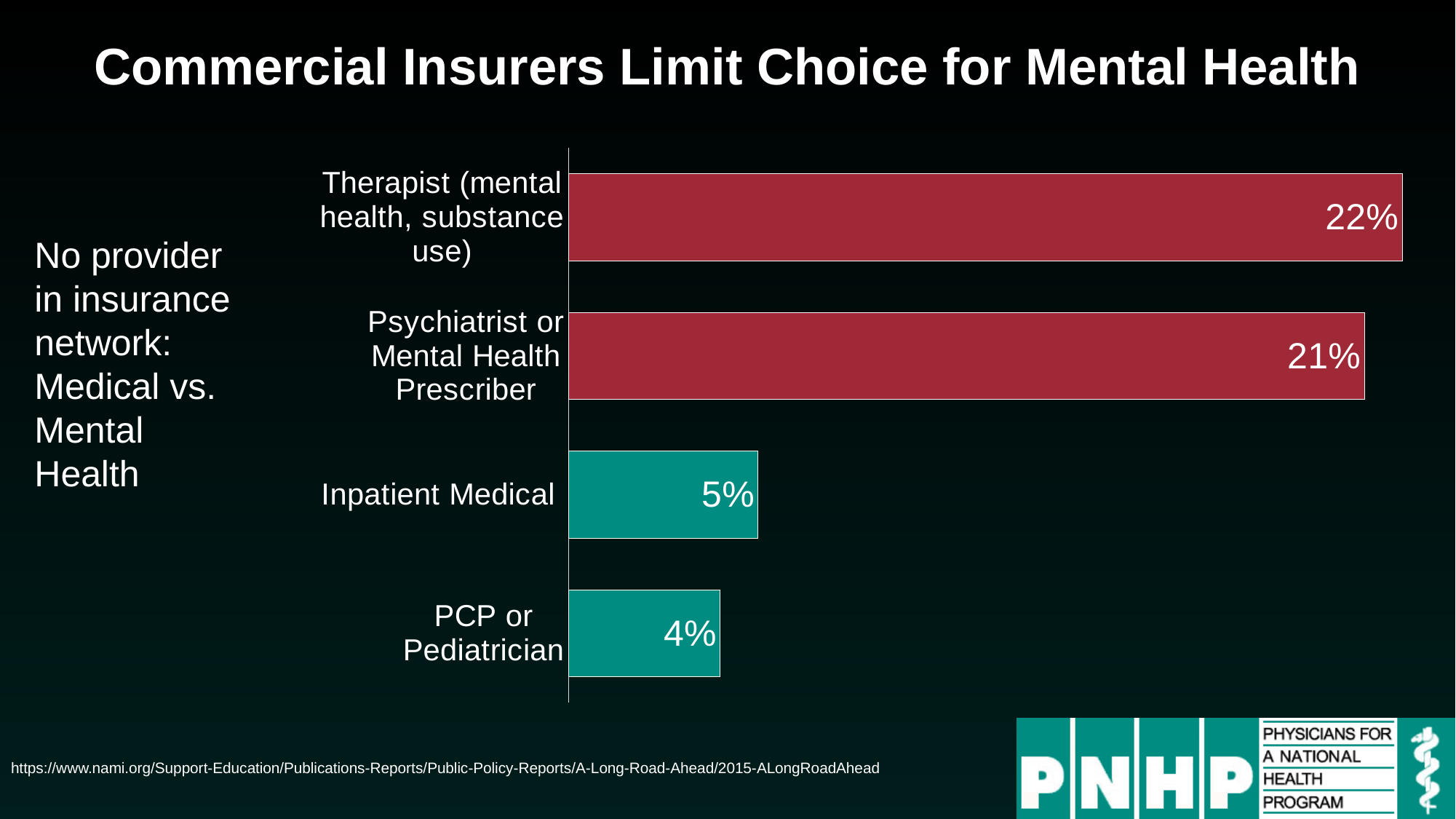
What is the value for PCP or Pediatrician? 4% What is the difference between the values for Therapist (mental health, substance use) and Inpatient Medical? 17% What kind of chart is shown on the slide? Bar chart Which is larger, the value for Psychiatrist or Mental Health Prescriber or the value for Inpatient Medical? Psychiatrist or Mental Health Prescriber How many categories are shown in the chart? 4 Which category has the highest value? Therapist (mental health, substance use) What is the value for Psychiatrist or Mental Health Prescriber? 21% Which category has the lowest value? PCP or Pediatrician What is the value for Inpatient Medical? 5% What is the difference between the values for Psychiatrist or Mental Health Prescriber and PCP or Pediatrician? 17% What is the value for Therapist (mental health, substance use)? 22% What colour are the bars for the mental health categories (Therapist and Psychiatrist)? Red